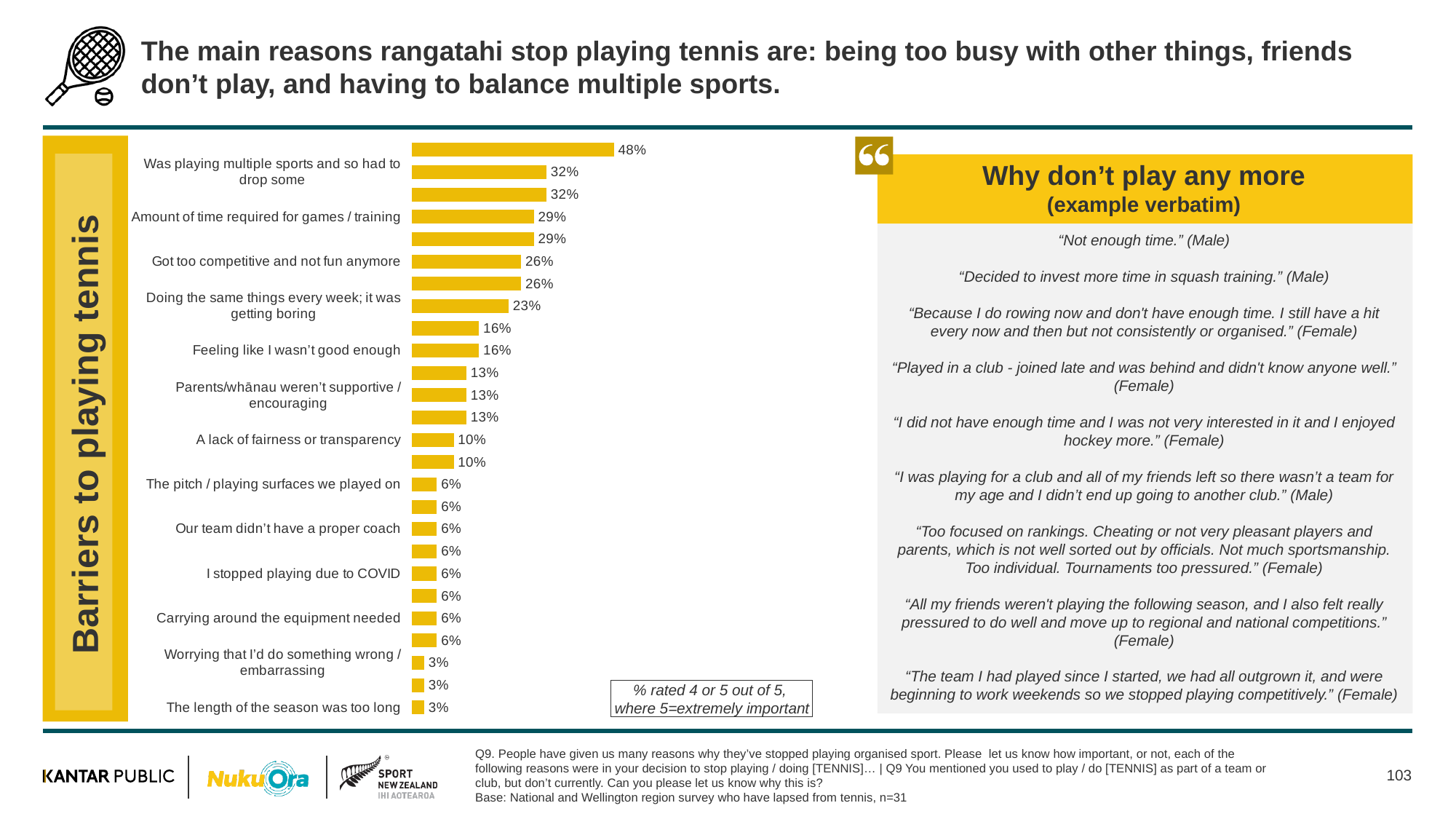
What is the value for 'Got too competitive and not fun anymore'? 26% Which is larger: 'A lack of fairness or transparency' or 'I stopped playing due to COVID'? A lack of fairness or transparency What is the value for 'Feeling like I wasn't good enough'? 16% What is the difference between 'Amount of time required for games / training' and 'Got too competitive and not fun anymore'? 3 percentage points What is the value for 'Doing the same things every week; it was getting boring'? 23% What is the value for 'Amount of time required for games / training'? 29% What is the value for 'Was playing multiple sports and so had to drop some'? 32% What type of chart is shown on the slide? Bar chart What is the highest value shown on the bar chart? 48% What is the title shown on the vertical band to the left of the bar chart? Barriers to playing tennis What is the value for 'Parents/whānau weren't supportive / encouraging'? 13% What is the value for 'The length of the season was too long'? 3%